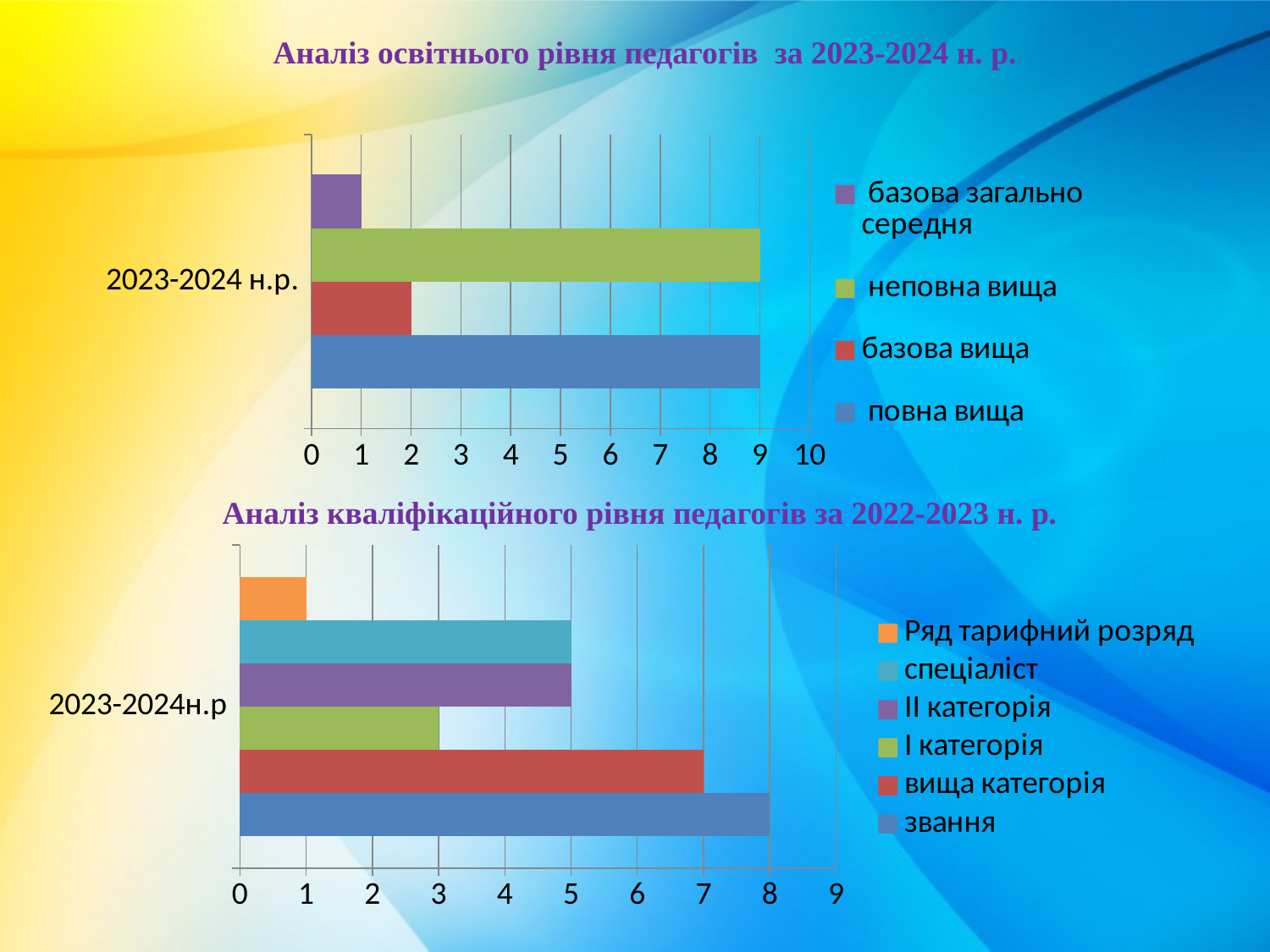
In the bottom chart (Аналіз кваліфікаційного рівня педагогів), what is the value for I категорія? 3 In the bottom chart (Аналіз кваліфікаційного рівня педагогів), which series has the lowest value? Ряд тарифний розряд In the bottom chart (Аналіз кваліфікаційного рівня педагогів), what is the value for вища категорія? 7 In the top chart (Аналіз освітнього рівня педагогів), what is the value for базова вища? 2 In the bottom chart (Аналіз кваліфікаційного рівня педагогів), which series has the highest value? звання In the bottom chart (Аналіз кваліфікаційного рівня педагогів), how many series does the legend list? 6 In the top chart (Аналіз освітнього рівня педагогів), how many series does the legend list? 4 In the top chart (Аналіз освітнього рівня педагогів), what is the difference between повна вища and базова вища? 7 In the top chart (Аналіз освітнього рівня педагогів), what is the value for неповна вища? 9 In the bottom chart (Аналіз кваліфікаційного рівня педагогів), which is larger: вища категорія or спеціаліст? вища категорія What kind of chart is the bottom chart (Аналіз кваліфікаційного рівня педагогів)? bar chart In the top chart (Аналіз освітнього рівня педагогів), which series has the lowest value? базова загально середня